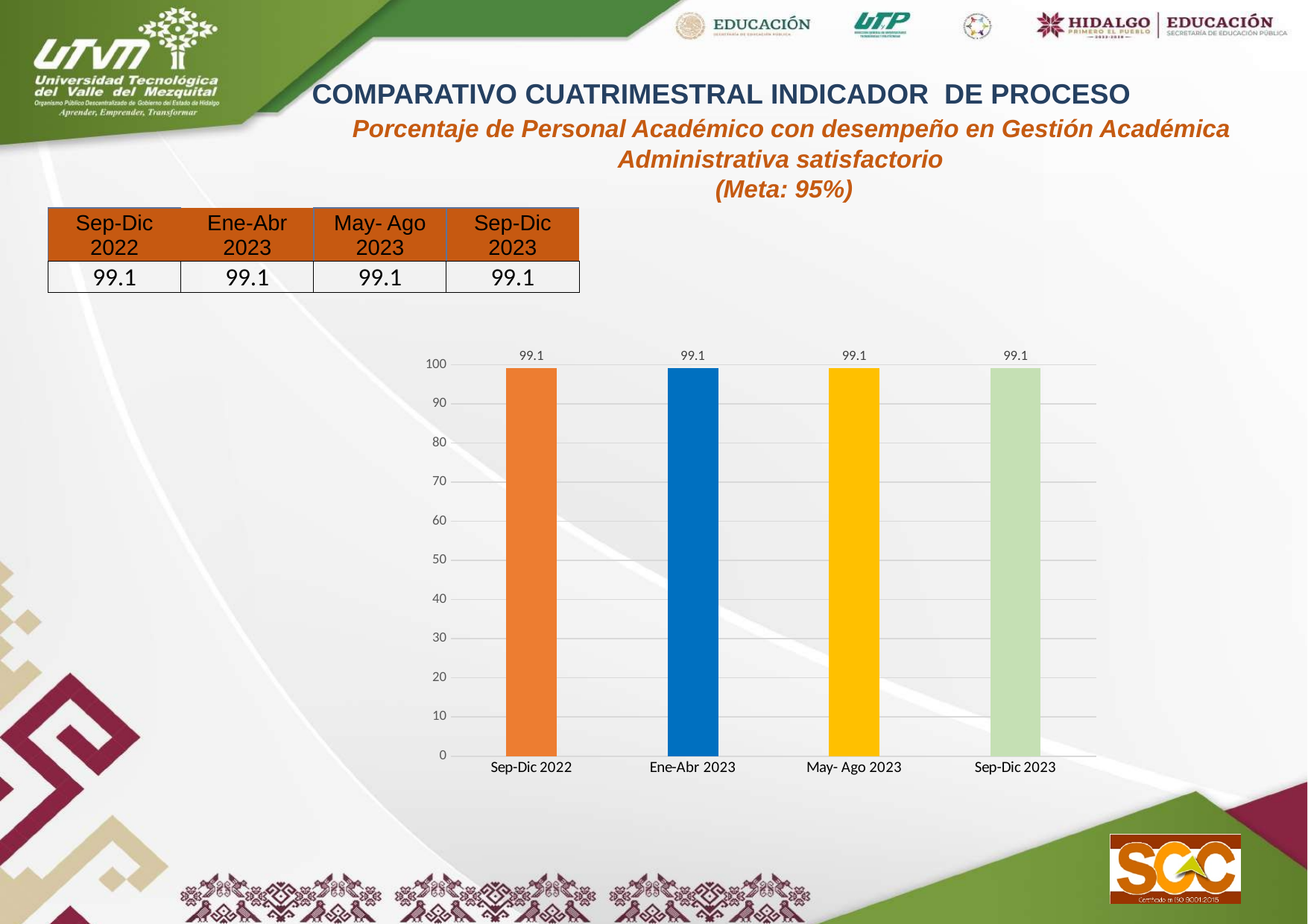
What kind of chart is shown on the slide? bar chart What is the target (Meta) stated in the chart's subtitle? 95% Is the value for May- Ago 2023 greater or less than 50? greater Do the values rise, fall or stay the same from Sep-Dic 2022 to Sep-Dic 2023? stay the same How many categories are shown on the x axis of the chart? 4 What is the difference between the values for Sep-Dic 2022 and Sep-Dic 2023? 0 What colour is the bar for Sep-Dic 2022? orange What is the value for May- Ago 2023? 99.1 Is the value for Ene-Abr 2023 greater or less than 90? greater What is the value for Ene-Abr 2023? 99.1 What is the value for Sep-Dic 2022? 99.1 What is the value for Sep-Dic 2023? 99.1